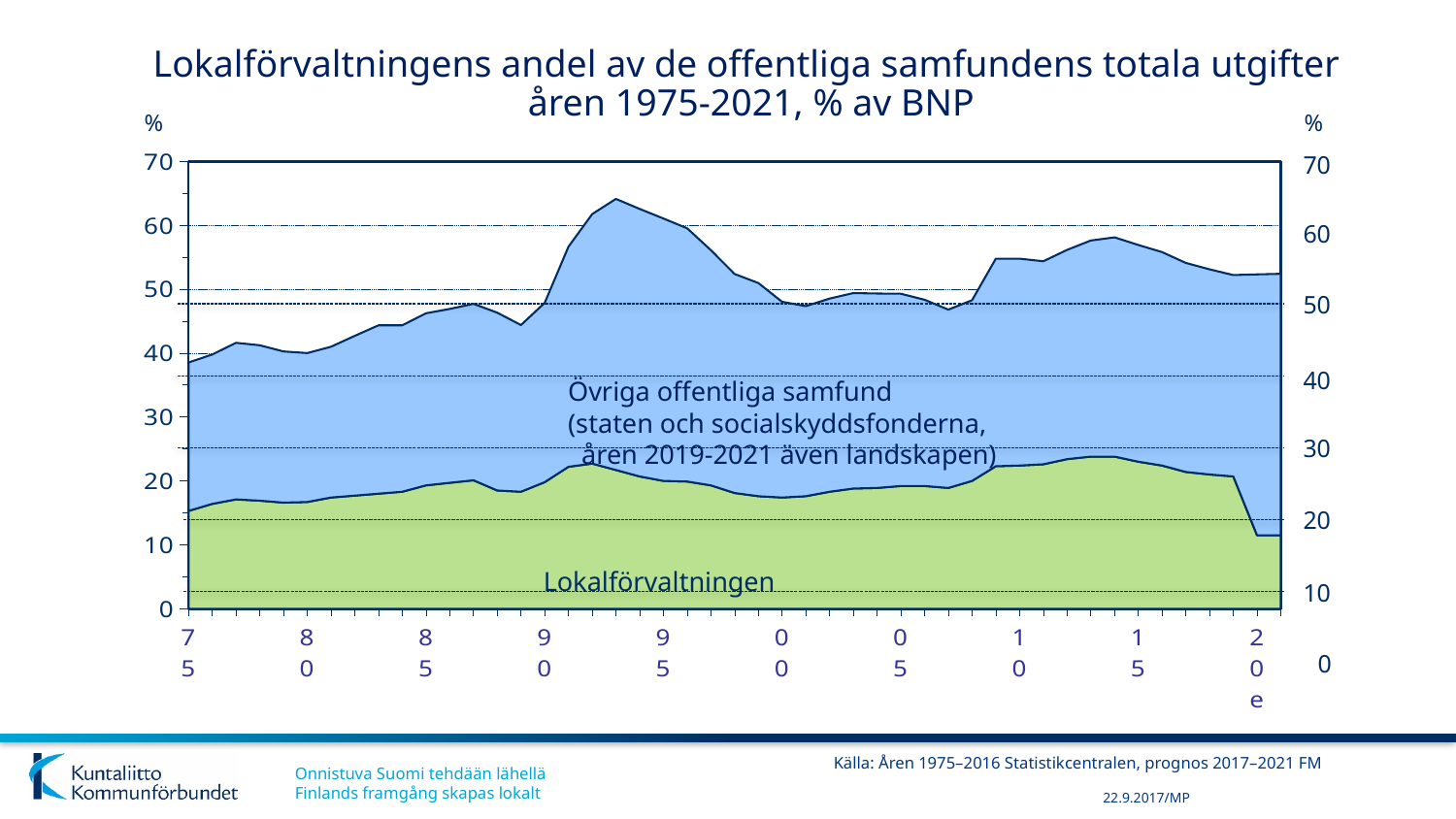
What kind of chart is shown on the slide? Area chart What is the unit shown on the vertical axes of the chart? % Is the total of the stacked areas in 1975 greater or less than 40? less Is the total of the stacked areas at 2020e greater or less than 50? greater Is the peak total of the stacked areas in the early 1990s greater or less than 60? greater Does the value for Lokalförvaltningen rise or fall between 1975 and 1990? rise Does the total of the stacked areas rise or fall between the early 1990s peak and 2000? fall How many series are plotted in the chart? 2 Which series is shown in green at the bottom of the chart? Lokalförvaltningen